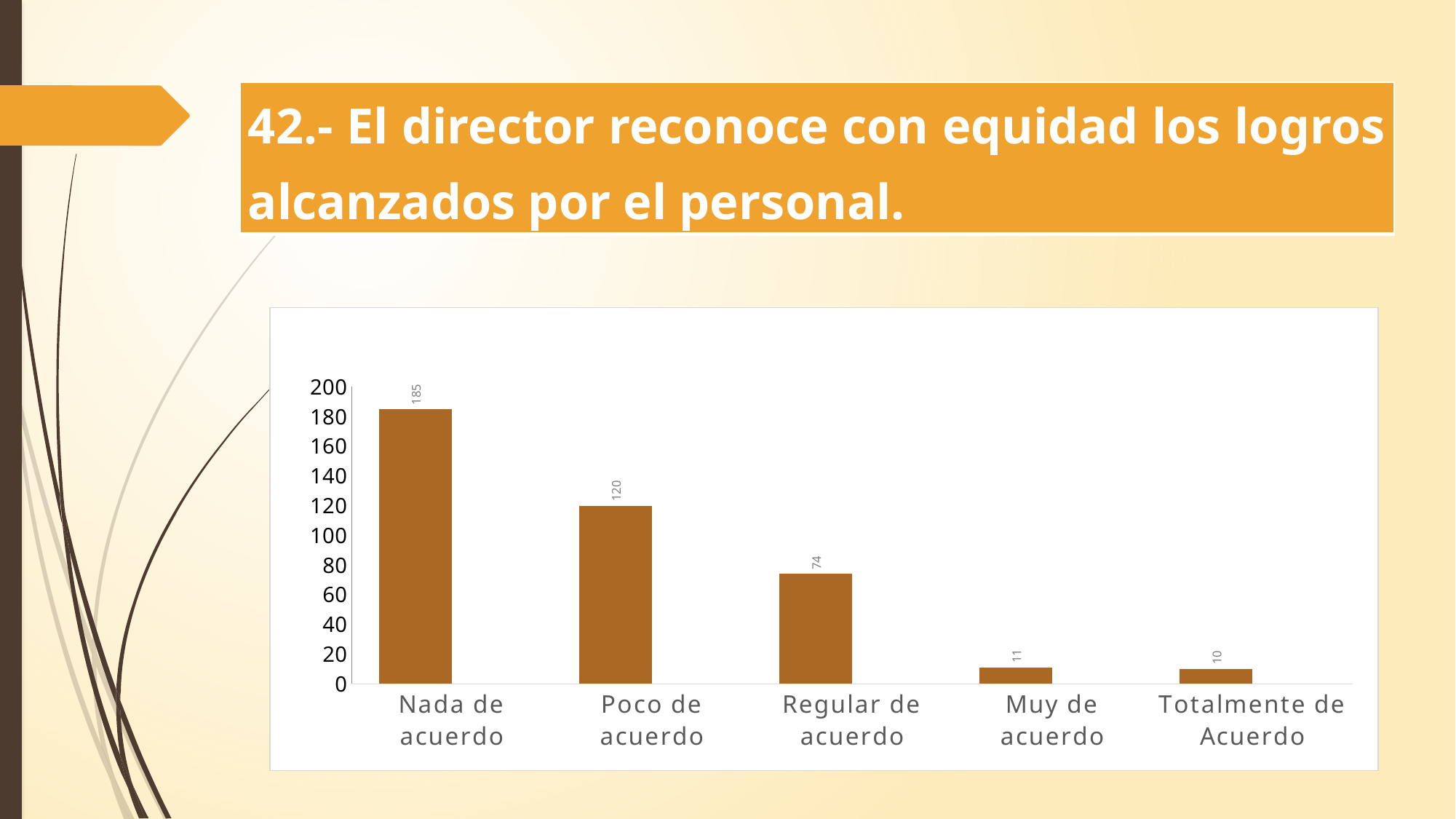
Is the value for "Regular de acuerdo" greater or less than 100? less What is the value for "Regular de acuerdo"? 74 What is the value for "Muy de acuerdo"? 11 How many categories are shown on the x axis? 5 What is the value for "Totalmente de Acuerdo"? 10 What is the value for "Nada de acuerdo"? 185 Do the values rise or fall from left to right along the x axis? fall What kind of chart is shown on the slide? bar chart Which category has the highest value? Nada de acuerdo What is the value for "Poco de acuerdo"? 120 What is the difference between the values for "Nada de acuerdo" and "Poco de acuerdo"? 65 Which is larger, the value for "Poco de acuerdo" or the value for "Regular de acuerdo"? Poco de acuerdo